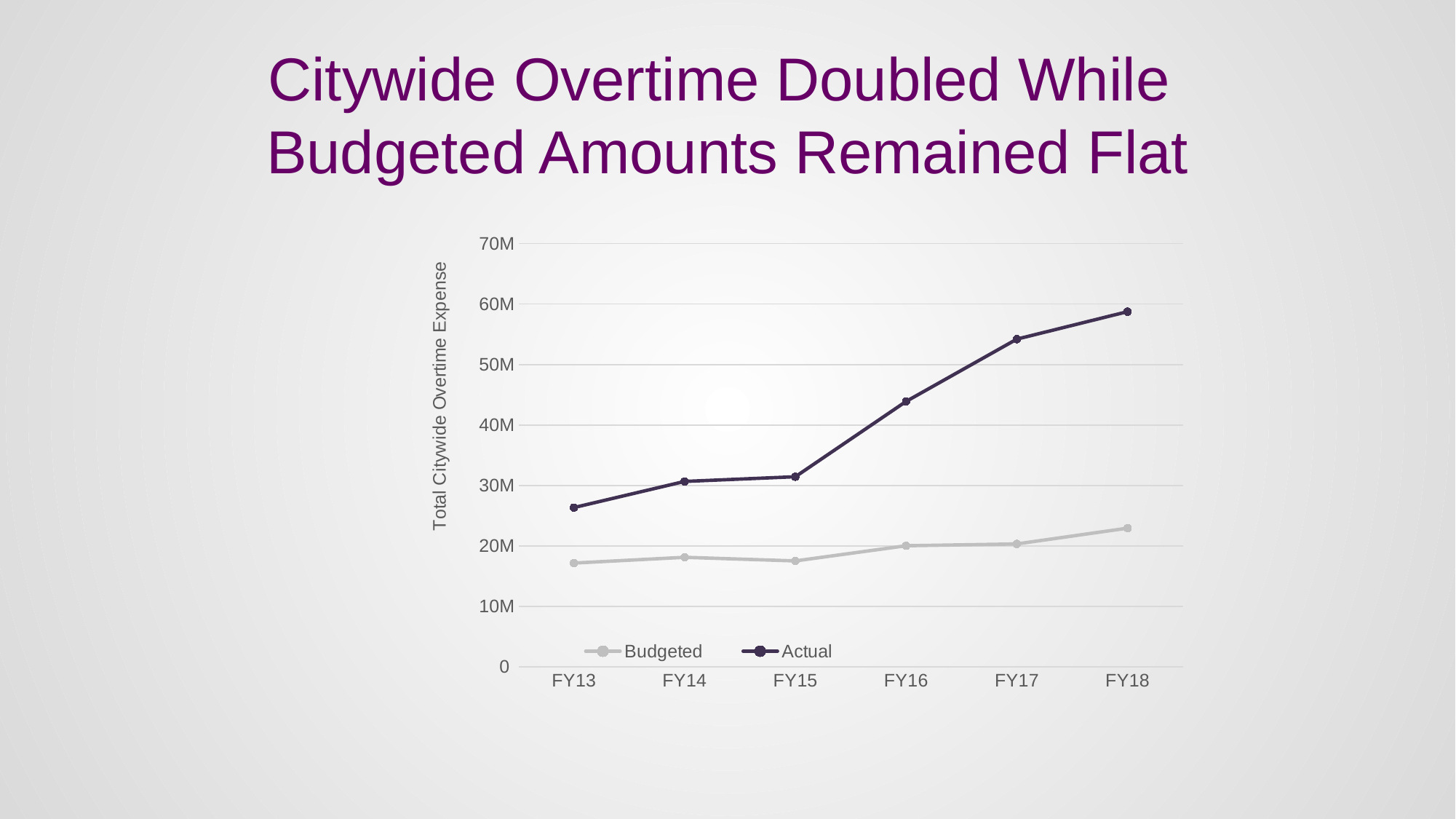
Is the Actual value for FY17 greater or less than 50M? greater What is the title of the slide? Citywide Overtime Doubled While Budgeted Amounts Remained Flat How many fiscal years are plotted along the x axis? 6 Is the Budgeted value for FY13 greater or less than 20M? less In which fiscal year is the Actual overtime expense lowest? FY13 What is the label on the vertical axis? Total Citywide Overtime Expense Does the Actual series rise or fall from FY13 to FY18? rise In which fiscal year is the Actual overtime expense highest? FY18 How many series does the legend list? 2 Is the Actual value for FY15 greater or less than 40M? less Which series is higher in FY18, Budgeted or Actual? Actual What kind of chart is shown on the slide? line chart